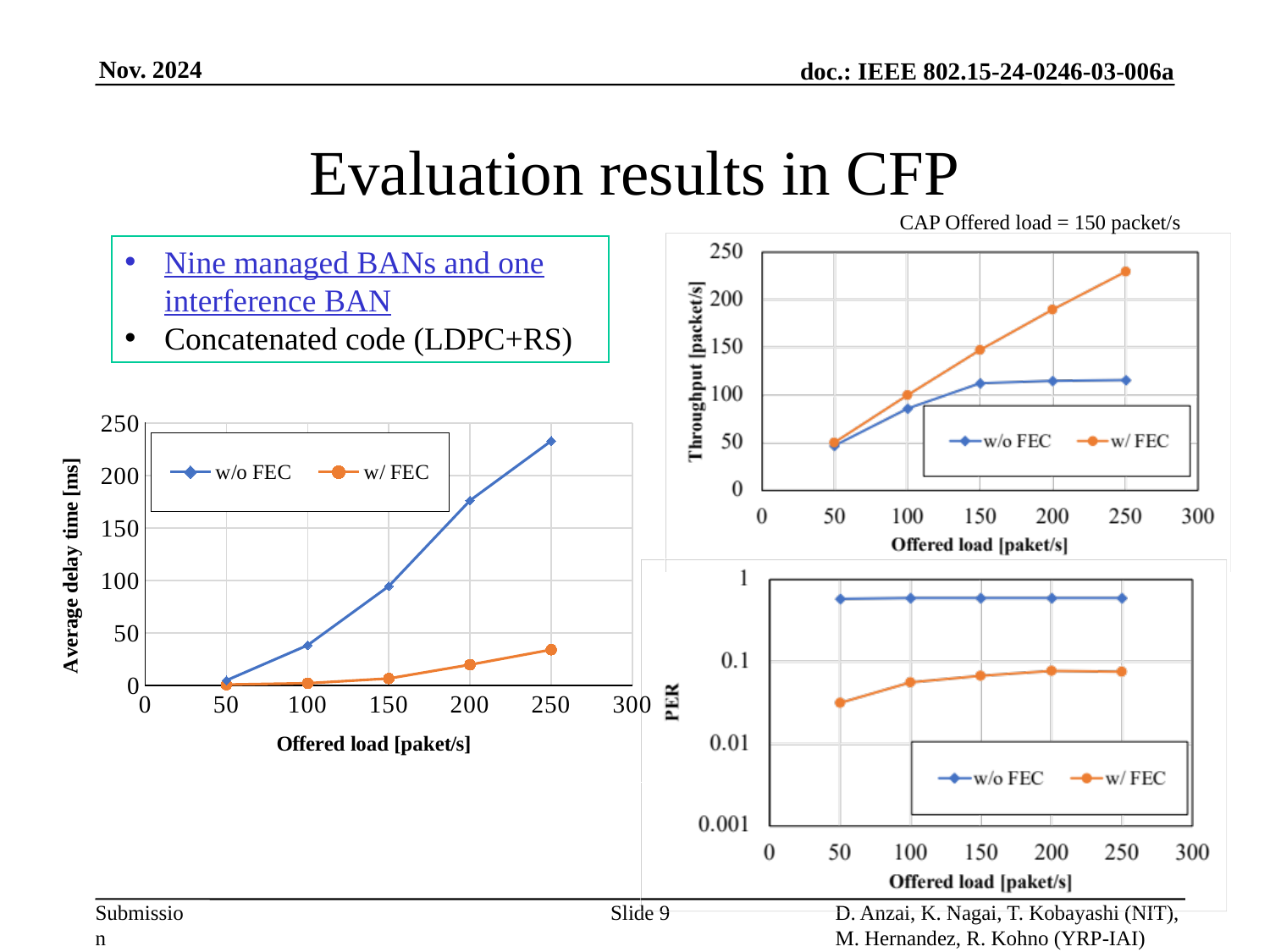
In the Average delay time chart, how many series does the legend list? 2 In the Throughput chart, is the w/ FEC value at an offered load of 250 greater or less than 200? greater In the Average delay time chart, is the w/o FEC value at an offered load of 250 greater or less than 200? greater In the Average delay time chart, what kind of chart is shown? line chart In the Throughput chart, is the w/o FEC value at an offered load of 100 greater or less than 100? less In the Average delay time chart, does the w/o FEC series rise or fall as offered load increases? rise In the Throughput chart, which series has the larger value at an offered load of 250, w/o FEC or w/ FEC? w/ FEC In the Average delay time chart, how many data points does the w/o FEC series have? 5 In the Average delay time chart, which series has the larger value at an offered load of 200, w/o FEC or w/ FEC? w/o FEC In the PER chart, which series has the higher PER across all offered loads, w/o FEC or w/ FEC? w/o FEC